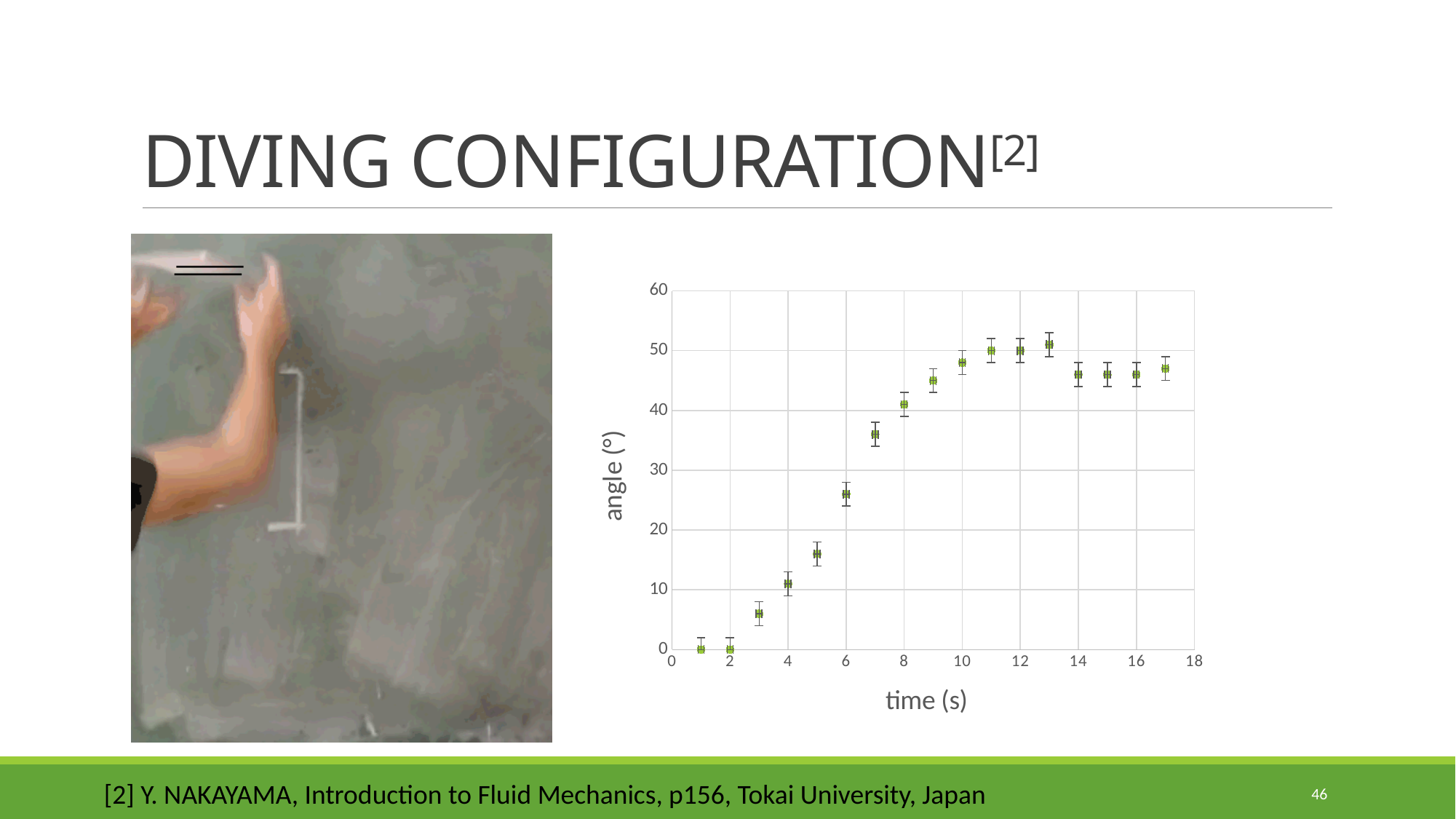
What is the angle value at time 2 s? 0 Is the angle value at time 6 s greater or less than 30? less How many data points are plotted on the chart? 17 Is the angle value at time 14 s greater or less than 40? greater What kind of chart is shown on the slide? scatter plot Is the angle value at time 4 s greater or less than 20? less How does the angle change as time increases from 1 s to 13 s? it rises What is the angle value at time 1 s? 0 What is the label of the y axis of the chart? angle (°) Which has the larger angle value: time 6 s or time 10 s? time 10 s What is the label of the x axis of the chart? time (s)